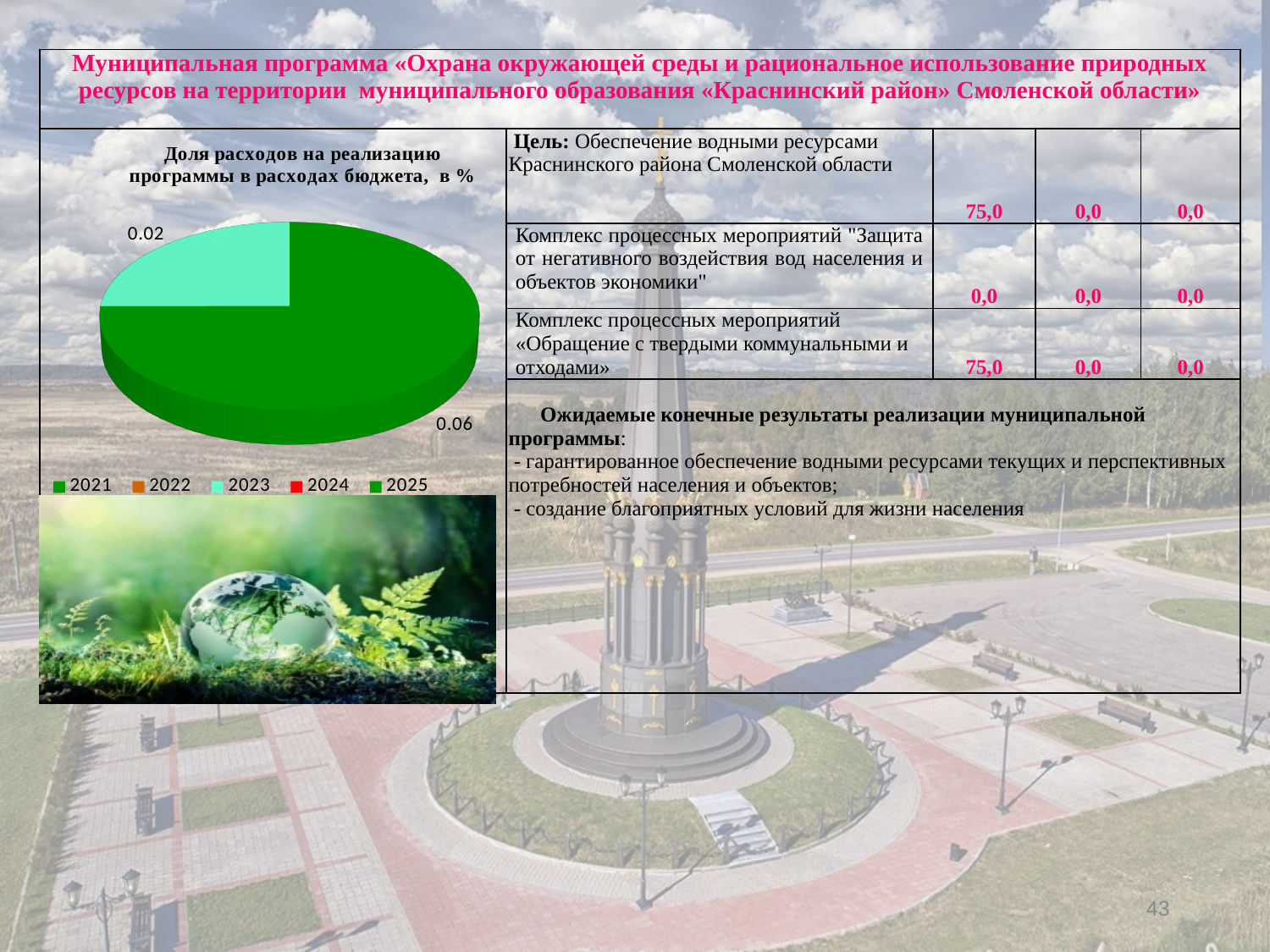
What is the title of the pie chart? Доля расходов на реализацию программы в расходах бюджета, в % What is the value of the smallest labelled slice in the pie chart? 0.02 What share of the pie does the 0.02 slice represent, given the two labelled values 0.06 and 0.02? 25% What is the difference between the two labelled slice values in the pie chart (0.06 and 0.02)? 0.04 How many entries does the legend of the pie chart list? 5 What value is shown for the light green (2023) slice of the pie chart? 0.02 How many slices with data labels are visible in the pie chart? 2 What is the value of the largest slice in the pie chart? 0.06 Which slice is larger in the pie chart: the dark green slice or the light green (2023) slice? The dark green slice Which years are listed in the legend of the pie chart? 2021, 2022, 2023, 2024, 2025 What kind of chart is shown on the slide? Pie chart